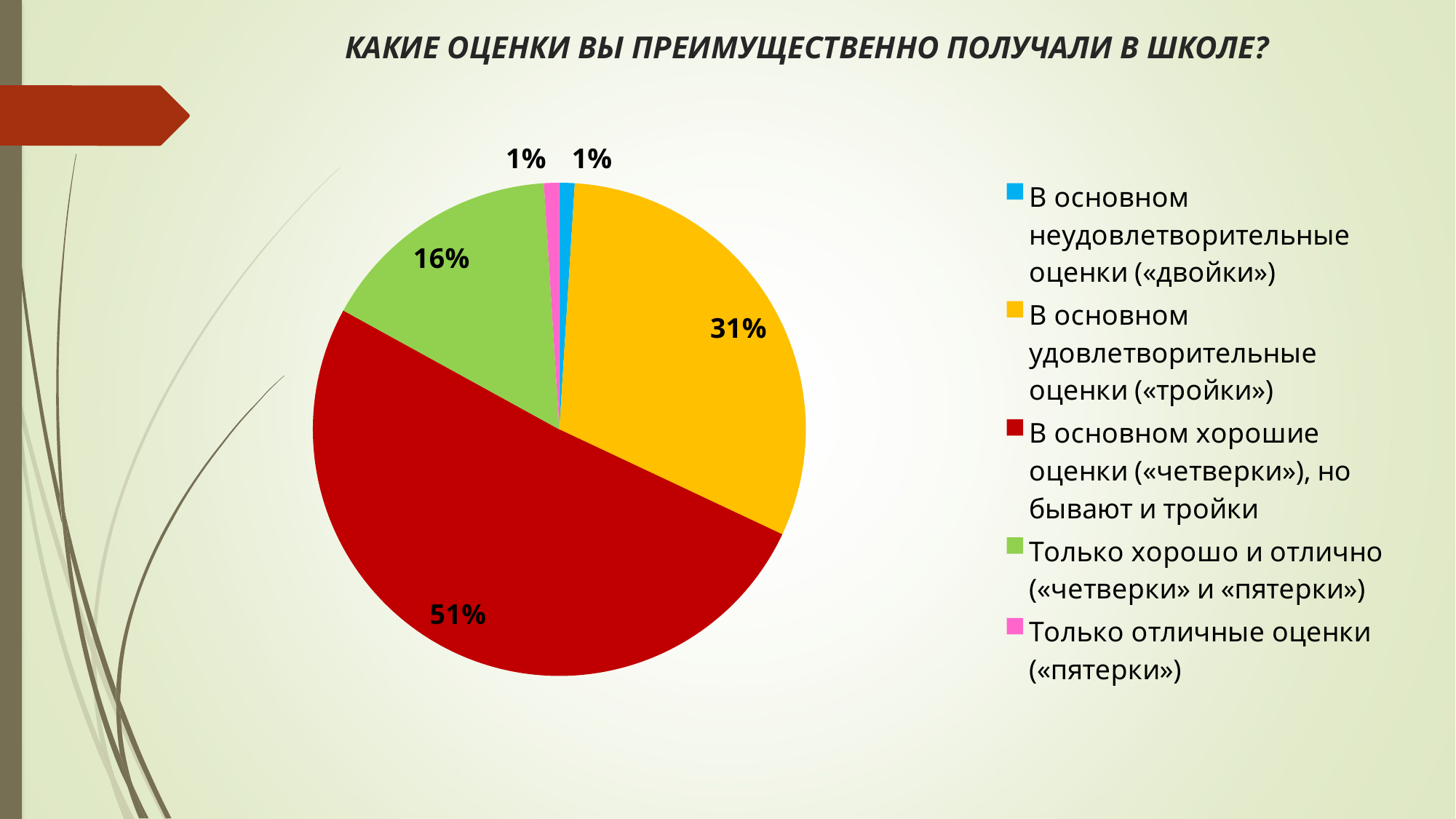
What share of respondents answered «В основном удовлетворительные оценки («тройки»)»? 31% What colour is the slice for «В основном неудовлетворительные оценки («двойки»)»? blue What is the title of the chart? КАКИЕ ОЦЕНКИ ВЫ ПРЕИМУЩЕСТВЕННО ПОЛУЧАЛИ В ШКОЛЕ? What share of respondents answered «Только отличные оценки («пятерки»)»? 1% What kind of chart is shown on the slide? pie chart What is the combined share of the two 1% slices («двойки» and «пятерки»)? 2% What is the difference in percentage points between the «четверки, но бывают и тройки» slice and the «тройки» slice? 20 How many categories does the pie chart have? 5 Which answer option has the largest share of the pie? В основном хорошие оценки («четверки»), но бывают и тройки What share of respondents answered «Только хорошо и отлично («четверки» и «пятерки»)»? 16% What share of respondents answered «В основном хорошие оценки («четверки»), но бывают и тройки»? 51% Which is larger: the share for «В основном удовлетворительные оценки («тройки»)» or the share for «Только хорошо и отлично («четверки» и «пятерки»)»? В основном удовлетворительные оценки («тройки»)